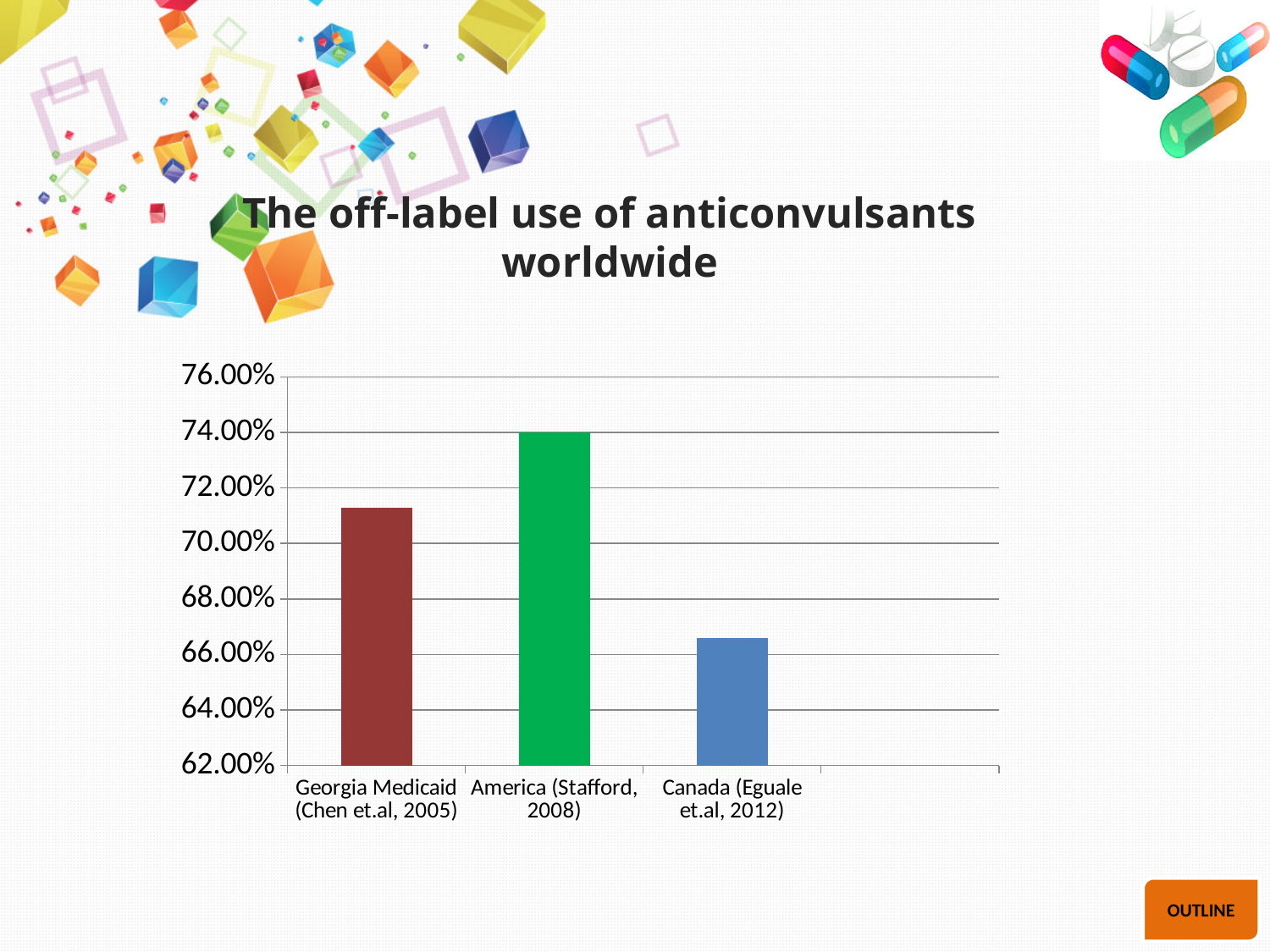
What colour is the bar for America (Stafford, 2008)? green How many categories are plotted in the chart? 3 Which is larger, the value for Georgia Medicaid (Chen et.al, 2005) or the value for Canada (Eguale et.al, 2012)? Georgia Medicaid (Chen et.al, 2005) Which category has the lowest value in the chart? Canada (Eguale et.al, 2012) What is the value for America (Stafford, 2008)? 74.00% Is the value for Canada (Eguale et.al, 2012) greater or less than 66.00%? greater Is the value for Georgia Medicaid (Chen et.al, 2005) greater or less than 70.00%? greater What is the title of the slide containing the chart? The off-label use of anticonvulsants worldwide Is the value for Canada (Eguale et.al, 2012) greater or less than 68.00%? less What kind of chart is shown on the slide? bar chart Which category has the highest value in the chart? America (Stafford, 2008)